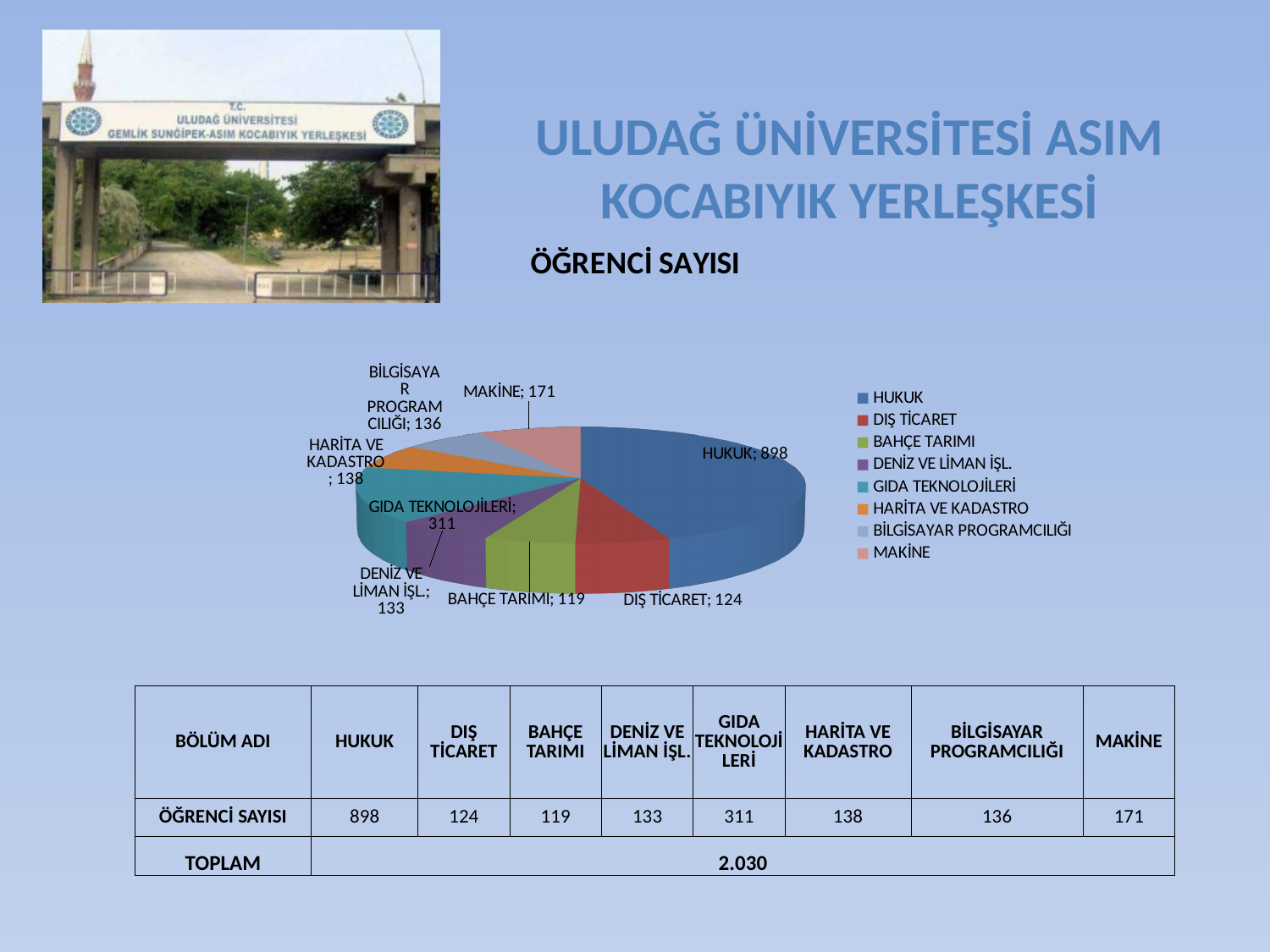
What kind of chart is shown on the slide? Pie chart What is the title of the chart? ÖĞRENCİ SAYISI What is the value for MAKİNE in the pie chart? 171 What is the value for HUKUK in the pie chart? 898 Which category has the largest slice in the pie chart? HUKUK What is the value for BİLGİSAYAR PROGRAMCILIĞI in the pie chart? 136 Which category has the smallest slice in the pie chart? BAHÇE TARIMI Which is larger, the value for DIŞ TİCARET or the value for BAHÇE TARIMI? DIŞ TİCARET What is the difference between the values for MAKİNE and BİLGİSAYAR PROGRAMCILIĞI? 35 What is the difference between the values for HUKUK and GIDA TEKNOLOJİLERİ? 587 What is the value for GIDA TEKNOLOJİLERİ in the pie chart? 311 How many categories are shown in the pie chart? 8